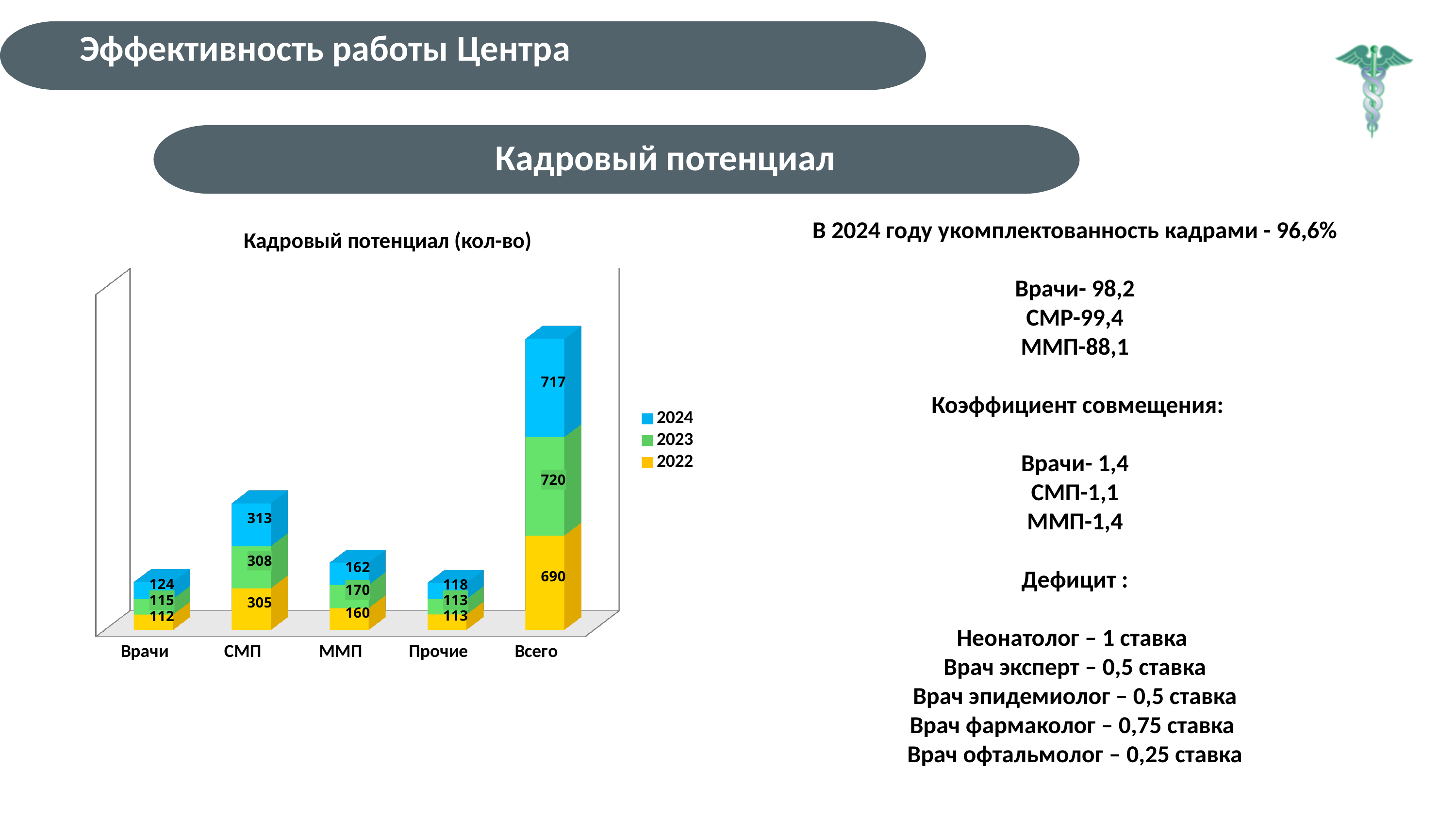
Which category has the highest value in the 2024 series? Всего Which is larger: the 2024 value for ММП or the 2023 value for ММП? 2023 value for ММП What is the value for Врачи in the 2024 series? 124 What is the difference between the 2024 and 2022 values for Врачи? 12 How many categories are shown on the x axis? 5 What is the value for ММП in the 2023 series? 170 What is the value for СМП in the 2022 series? 305 Which category has the lowest value in the 2022 series? Врачи What is the value for Всего in the 2023 series? 720 What is the title of the chart? Кадровый потенциал (кол-во) How many series does the legend list? 3 What kind of chart is shown on the slide? Stacked bar chart